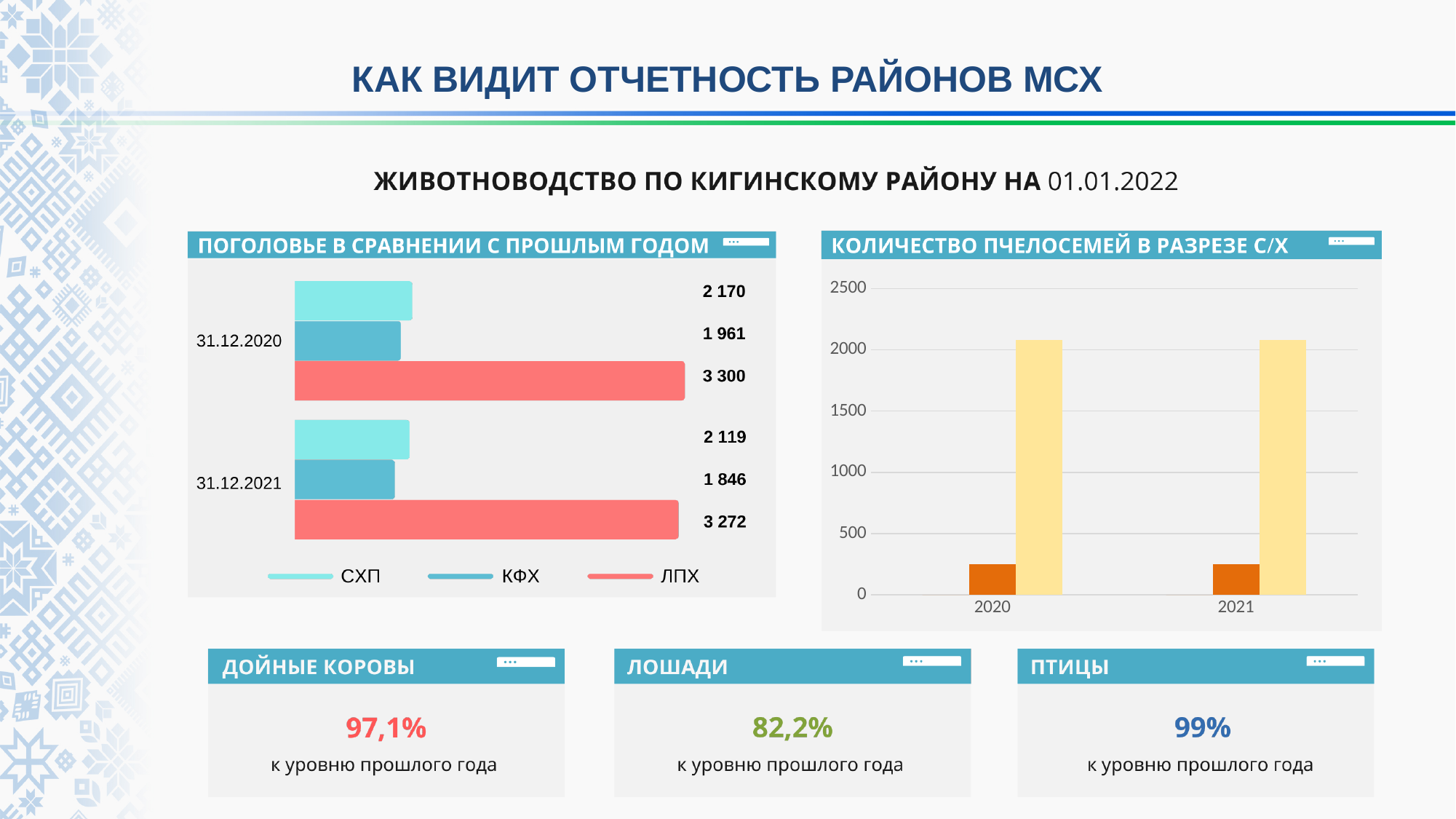
In the chart 'КОЛИЧЕСТВО ПЧЕЛОСЕМЕЙ В РАЗРЕЗЕ С/Х', is the value of the orange bar for 2021 greater or less than 500? less In the chart 'ПОГОЛОВЬЕ В СРАВНЕНИИ С ПРОШЛЫМ ГОДОМ', which series has the highest value on 31.12.2021? ЛПХ How many years are shown on the x axis of the chart 'КОЛИЧЕСТВО ПЧЕЛОСЕМЕЙ В РАЗРЕЗЕ С/Х'? 2 In the chart 'ПОГОЛОВЬЕ В СРАВНЕНИИ С ПРОШЛЫМ ГОДОМ', what is the difference between the СХП values on 31.12.2020 and 31.12.2021? 51 In the chart 'ПОГОЛОВЬЕ В СРАВНЕНИИ С ПРОШЛЫМ ГОДОМ', what is the value for СХП on 31.12.2020? 2 170 In the chart 'ПОГОЛОВЬЕ В СРАВНЕНИИ С ПРОШЛЫМ ГОДОМ', what is the value for ЛПХ on 31.12.2020? 3 300 How many series does the legend of the chart 'ПОГОЛОВЬЕ В СРАВНЕНИИ С ПРОШЛЫМ ГОДОМ' list? 3 What kind of chart is 'КОЛИЧЕСТВО ПЧЕЛОСЕМЕЙ В РАЗРЕЗЕ С/Х'? bar chart In the chart 'ПОГОЛОВЬЕ В СРАВНЕНИИ С ПРОШЛЫМ ГОДОМ', is the ЛПХ value larger on 31.12.2020 or on 31.12.2021? 31.12.2020 In the chart 'ПОГОЛОВЬЕ В СРАВНЕНИИ С ПРОШЛЫМ ГОДОМ', which series has the lowest value on 31.12.2020? КФХ In the chart 'ПОГОЛОВЬЕ В СРАВНЕНИИ С ПРОШЛЫМ ГОДОМ', what is the value for КФХ on 31.12.2021? 1 846